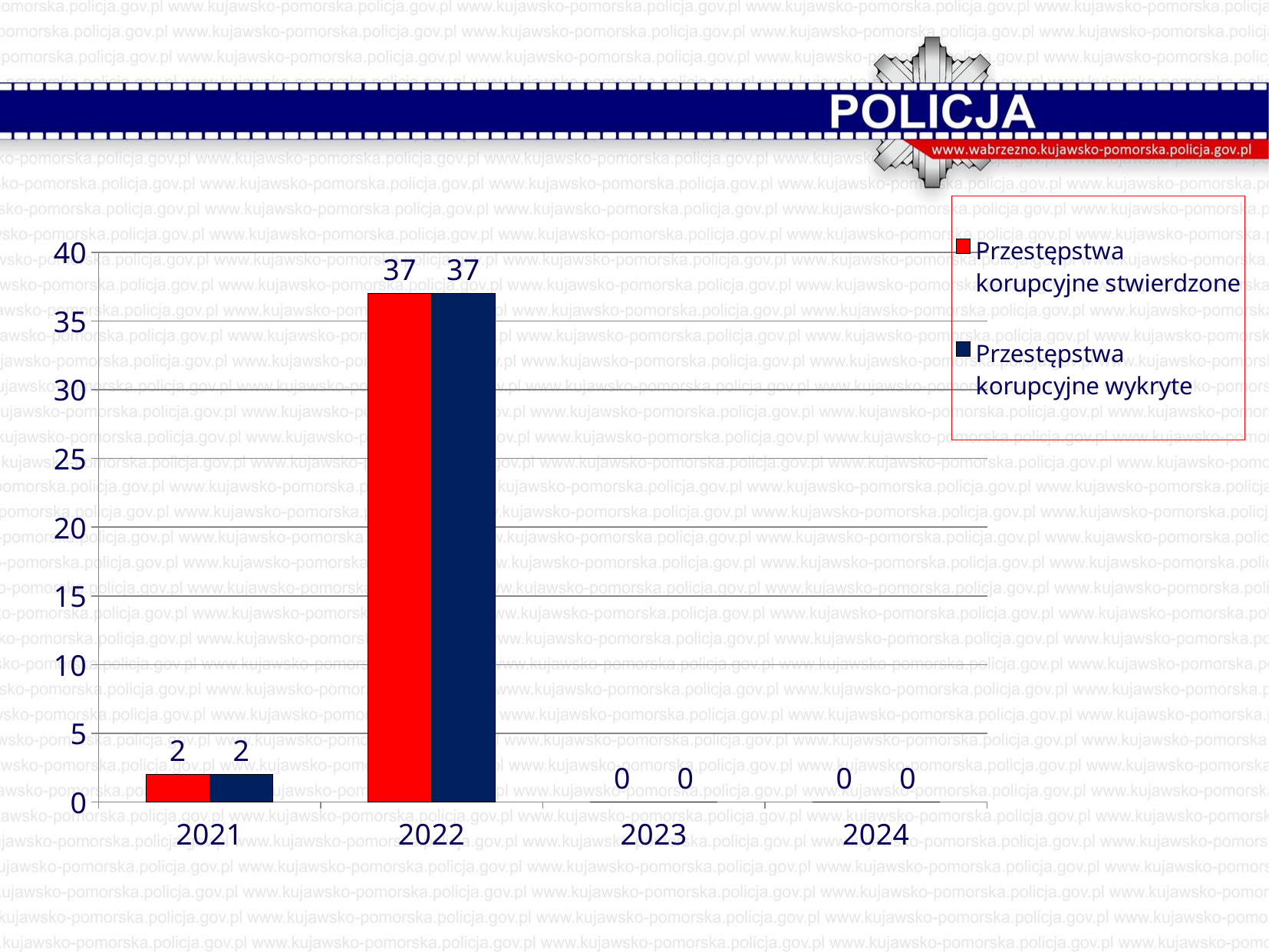
What kind of chart is shown on the slide? bar chart How many series does the legend list? 2 Which colour represents Przestępstwa korupcyjne wykryte in the legend? dark blue How many years are shown on the x axis? 4 In which year is Przestępstwa korupcyjne stwierdzone highest? 2022 What is the value of Przestępstwa korupcyjne stwierdzone in 2023? 0 What is the value of Przestępstwa korupcyjne stwierdzone in 2022? 37 Is the value of Przestępstwa korupcyjne stwierdzone in 2022 greater or less than 35? greater What is the difference between Przestępstwa korupcyjne stwierdzone in 2022 and in 2021? 35 What is the value of Przestępstwa korupcyjne wykryte in 2021? 2 What is the value of Przestępstwa korupcyjne wykryte in 2024? 0 Which is larger: Przestępstwa korupcyjne wykryte in 2021 or in 2022? 2022